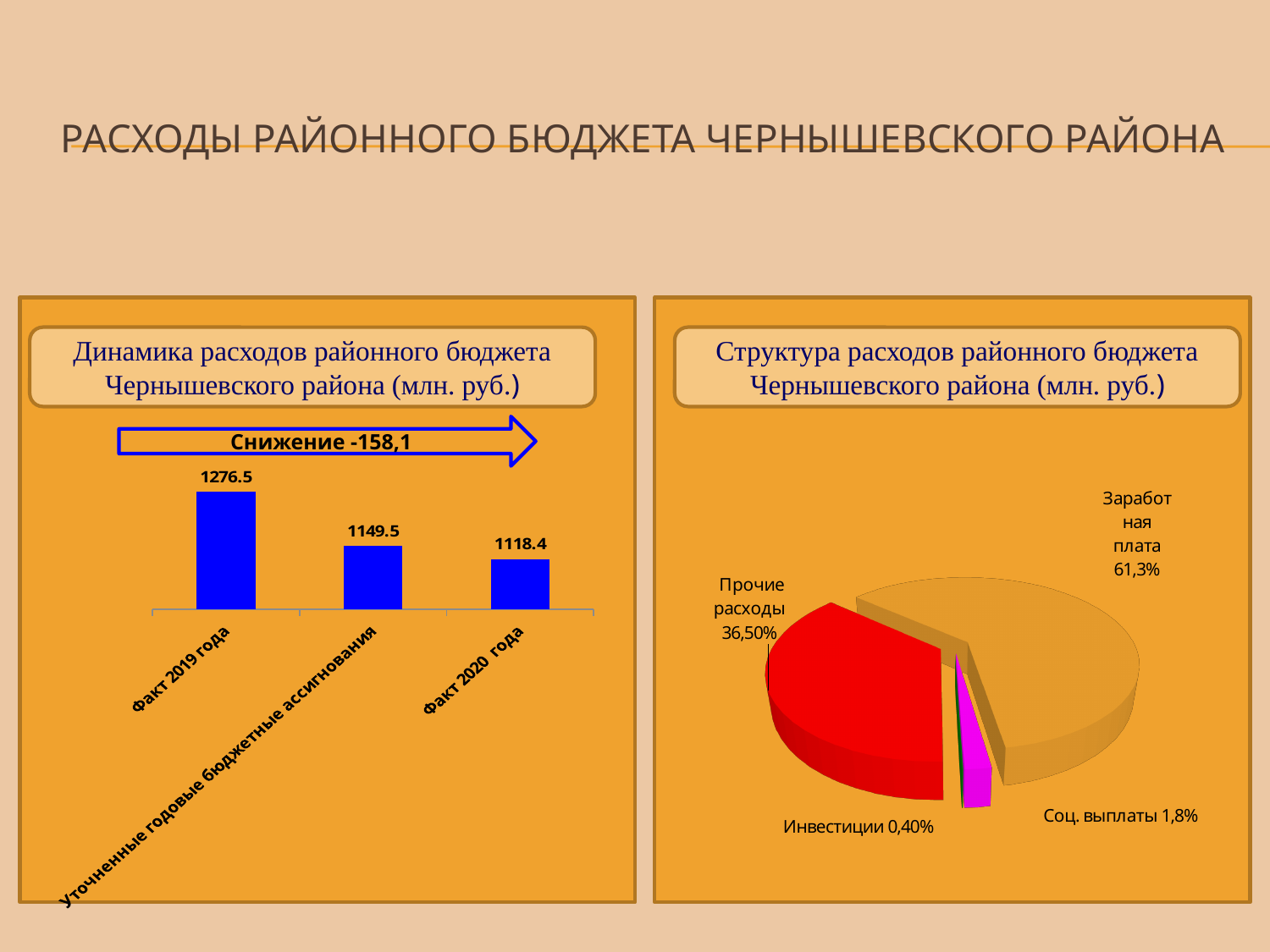
In the left chart (Динамика расходов районного бюджета), do the values rise or fall from left to right? fall What type of chart is the left chart (Динамика расходов районного бюджета)? bar chart In the left chart (Динамика расходов районного бюджета), what is the value for Факт 2020 года? 1118.4 In the left chart (Динамика расходов районного бюджета), which category has the highest value? Факт 2019 года In the right chart (Структура расходов районного бюджета), what share does Заработная плата have? 61,3% In the right chart (Структура расходов районного бюджета), which is larger: Соц. выплаты or Инвестиции? Соц. выплаты In the left chart (Динамика расходов районного бюджета), how many bars are plotted? 3 In the left chart (Динамика расходов районного бюджета), what is the value for Уточненные годовые бюджетные ассигнования? 1149.5 In the left chart (Динамика расходов районного бюджета), what is the value for Факт 2019 года? 1276.5 In the right chart (Структура расходов районного бюджета), what share does Прочие расходы have? 36,50% In the left chart (Динамика расходов районного бюджета), what is the difference between Факт 2019 года and Факт 2020 года? 158.1 In the left chart (Динамика расходов районного бюджета), which category has the lowest value? Факт 2020 года